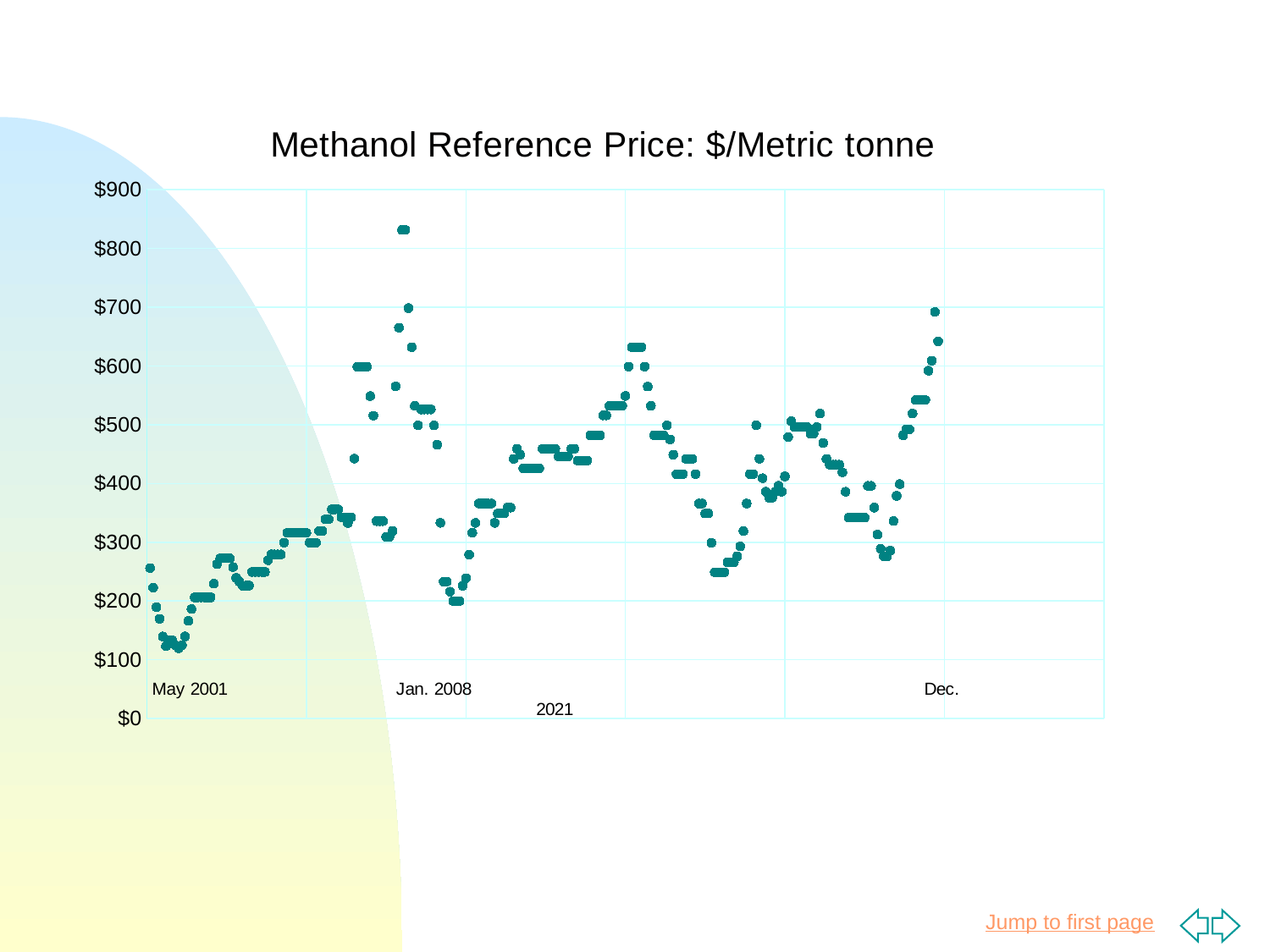
Are the lowest price points on the chart, shortly after May 2001, greater or less than $200? less What kind of chart is shown on the slide? scatter chart What is the highest value shown on the vertical axis? $900 Is the highest price point on the chart, near Jan. 2008, greater or less than $800? greater Which is higher: the peak price near Jan. 2008 or the peak price near Dec. 2021? Jan. 2008 What is the title of the chart? Methanol Reference Price: $/Metric tonne Overall, do prices rise or fall from May 2001 to Jan. 2008? rise Near which labelled date on the x axis does the price reach its highest point? Jan. 2008 How many date labels are shown along the x axis? 3 Is the last price point on the chart, near Dec. 2021, greater or less than $600? greater Near which labelled date on the x axis does the price reach its lowest point? May 2001